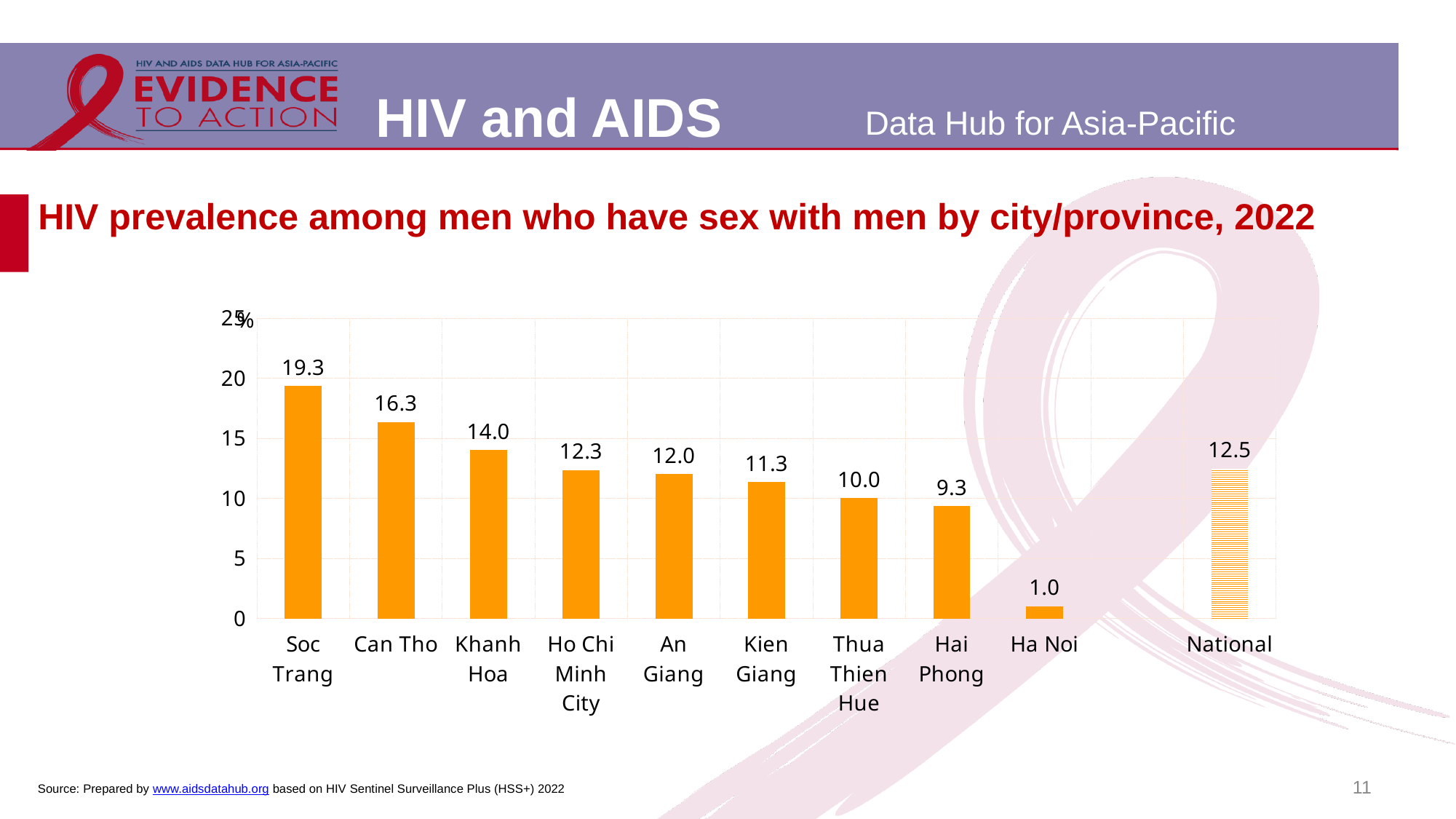
What is the difference between the National value and the value for Hai Phong? 3.2 What is the difference between the values for Soc Trang and Can Tho? 3.0 Which is larger, the value for Khanh Hoa or the value for Kien Giang? Khanh Hoa What kind of chart is shown on the slide? Bar chart What is the HIV prevalence value shown for Soc Trang? 19.3 What is the National value shown on the chart? 12.5 How many bars are plotted on the chart? 10 Which city/province has the highest HIV prevalence on the chart? Soc Trang What is the value shown for Thua Thien Hue? 10.0 Do the values for the cities/provinces rise or fall from left to right, from Soc Trang to Ha Noi? Fall What is the value shown for Ha Noi? 1.0 Which city/province has the lowest HIV prevalence on the chart? Ha Noi